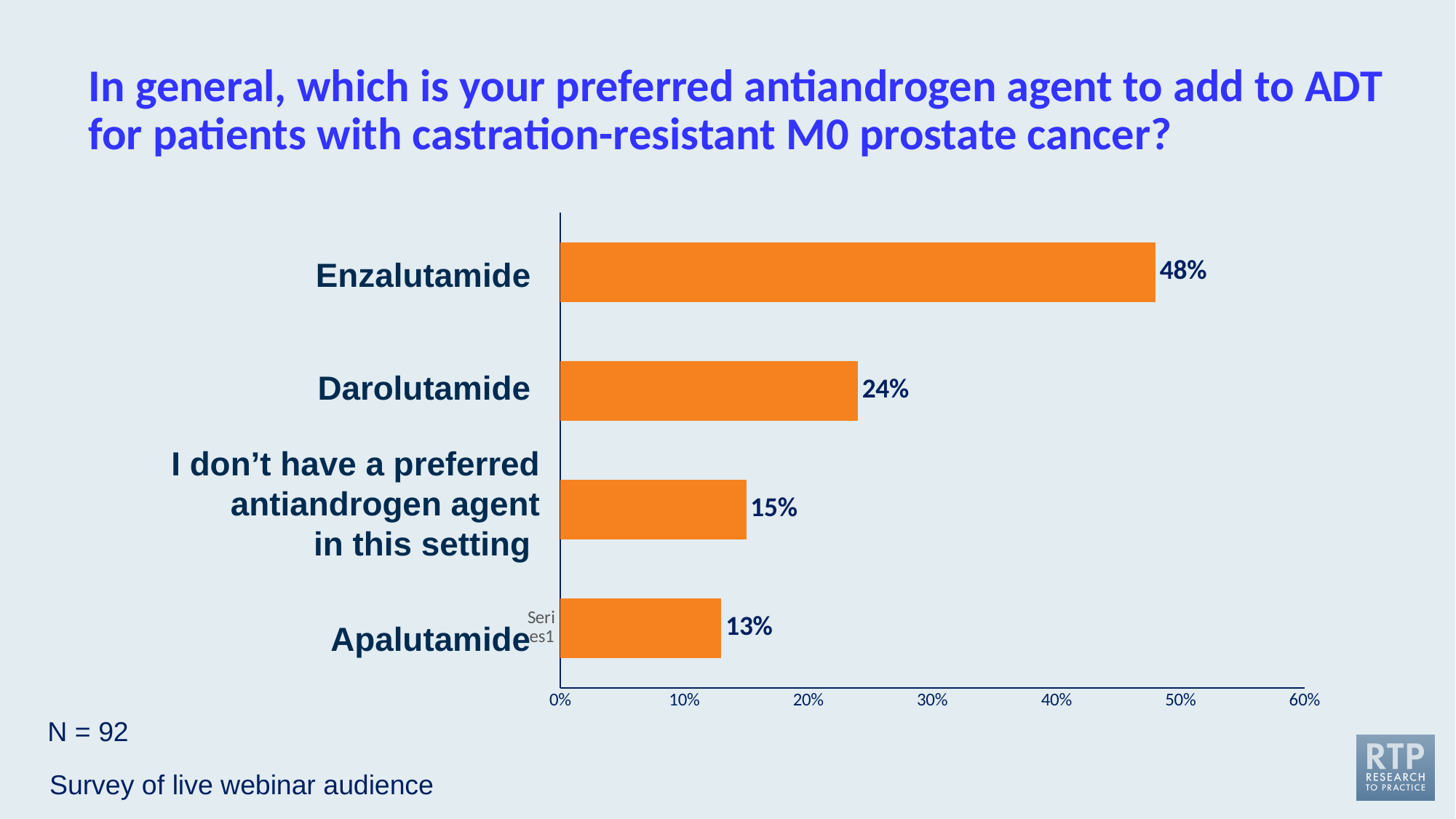
How many response categories are shown in the chart? 4 What type of chart is shown on the slide? Bar chart What is the difference in percentage points between Darolutamide and Apalutamide? 11% Which received a larger share of responses, Darolutamide or Apalutamide? Darolutamide What percentage of respondents said they don't have a preferred antiandrogen agent in this setting? 15% What is the sample size (N) stated on the slide? 92 Which response received the highest percentage? Enzalutamide What is the difference in percentage points between Enzalutamide and Darolutamide? 24% What percentage of respondents chose Darolutamide? 24% Which response received the lowest percentage? Apalutamide What percentage of respondents chose Enzalutamide? 48% What percentage of respondents chose Apalutamide? 13%